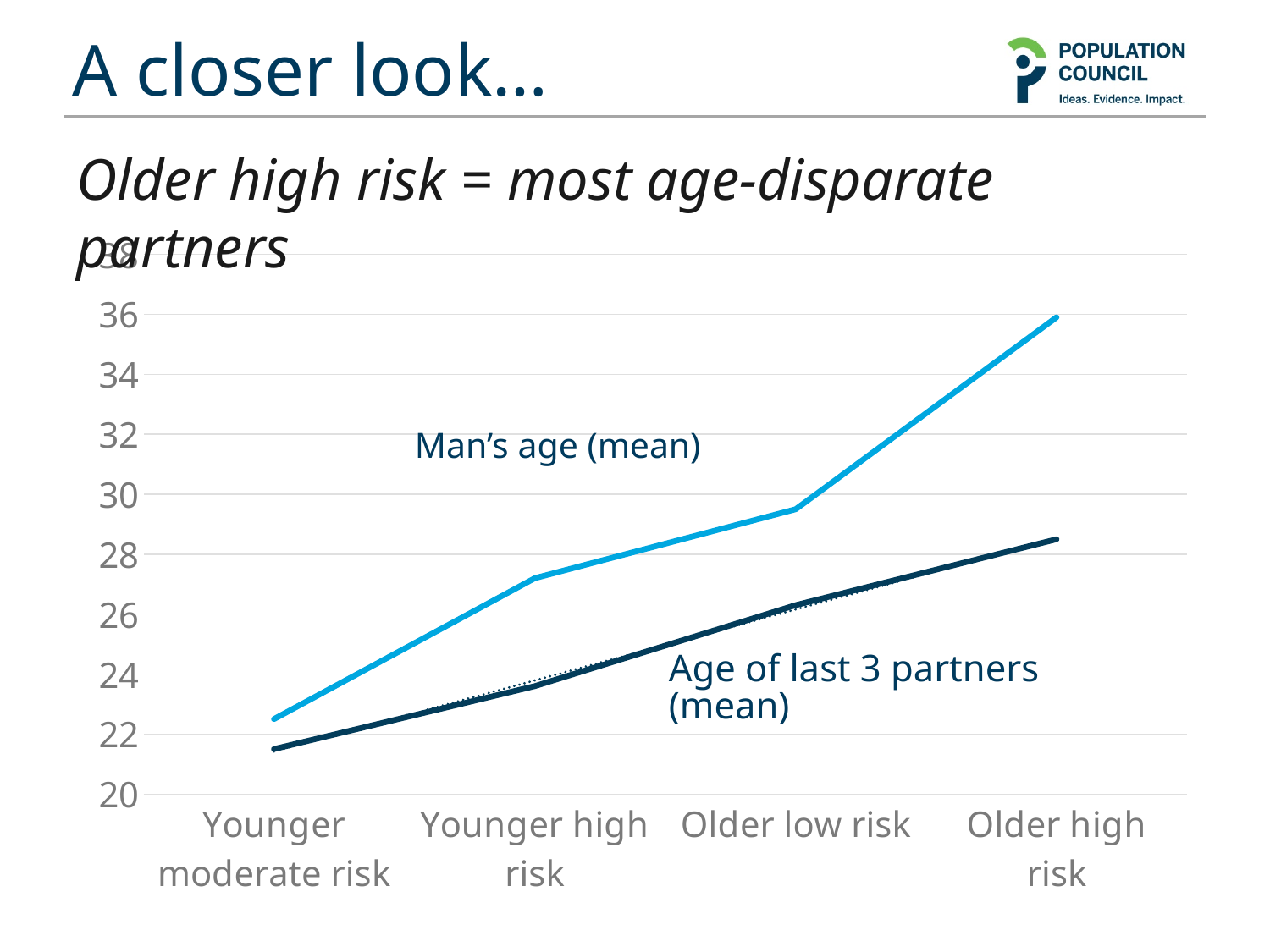
For Older high risk, which is larger: Man's age (mean) or Age of last 3 partners (mean)? Man's age (mean) Is the value of Man's age (mean) for Older high risk greater or less than 34? greater Do the values for Man's age (mean) rise or fall from left to right along the x axis? rise How many series are plotted on the chart? 2 Is the value of Age of last 3 partners (mean) for Older high risk greater or less than 30? less Is the value of Man's age (mean) for Younger moderate risk greater or less than 24? less What is the label of the series drawn with the lighter blue line? Man's age (mean) What kind of chart is shown on the slide? line chart How many categories are shown on the x axis of the chart? 4 Which category has the highest value for Man's age (mean)? Older high risk Which category has the lowest value for Age of last 3 partners (mean)? Younger moderate risk